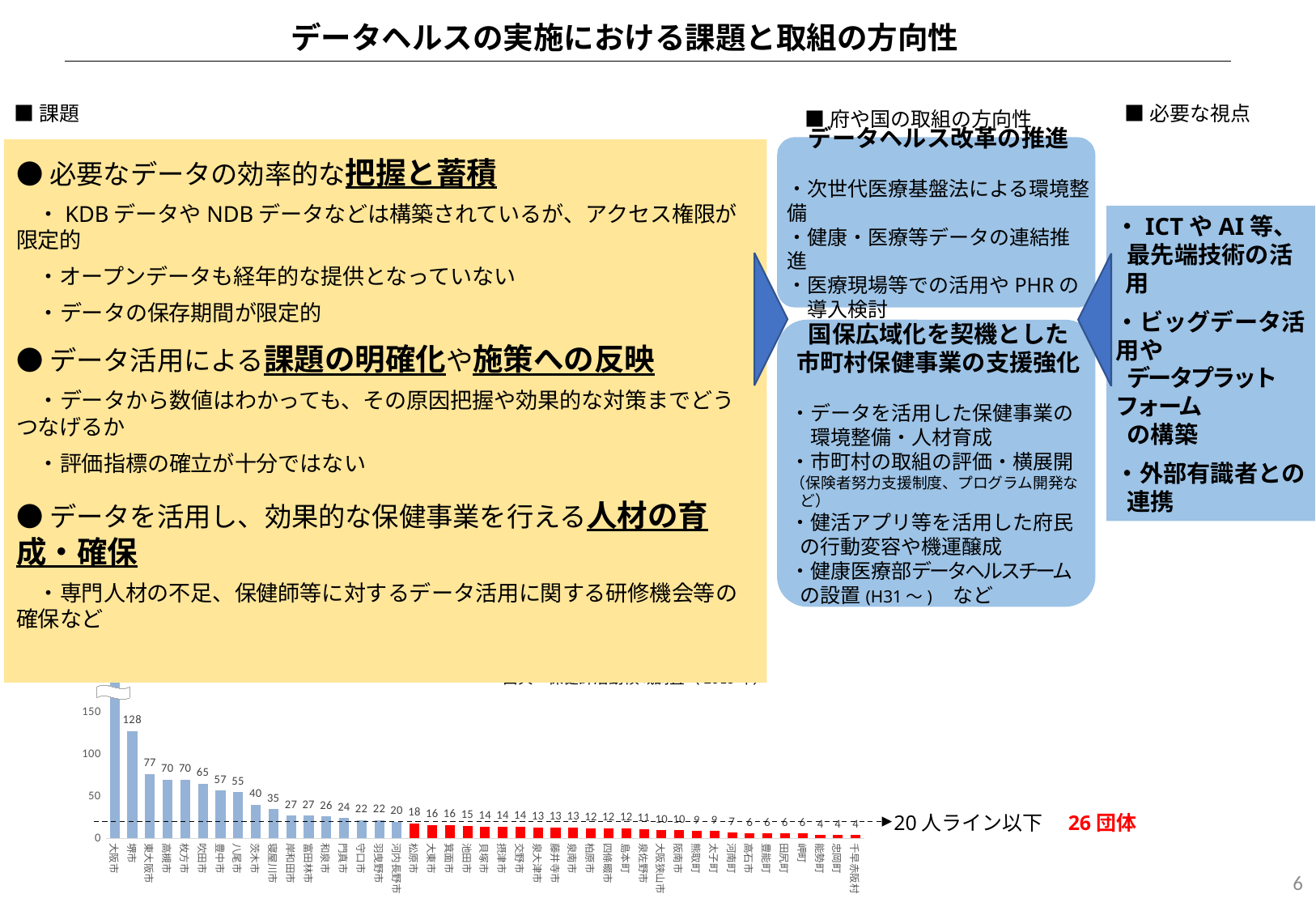
In the bar chart, which has a larger value, 豊中市 or 寝屋川市? 豊中市 In the bar chart, is the value for 大阪市 greater or less than 150? greater In the bar chart, what is the value for 河内長野市? 20 In the bar chart, what is the value for 茨木市? 40 In the bar chart, what is the value for 吹田市? 65 In the bar chart, which municipality has the highest value? 大阪市 In the bar chart, what is the difference between the values for 堺市 and 東大阪市? 51 In the bar chart, what is the value for 東大阪市? 77 What type of chart is shown at the bottom of the slide? bar chart According to the annotation next to the bar chart, how many organizations are below the 20-person line? 26 団体 In the bar chart, what is the value for 堺市? 128 How many municipalities are shown in the bar chart? 43